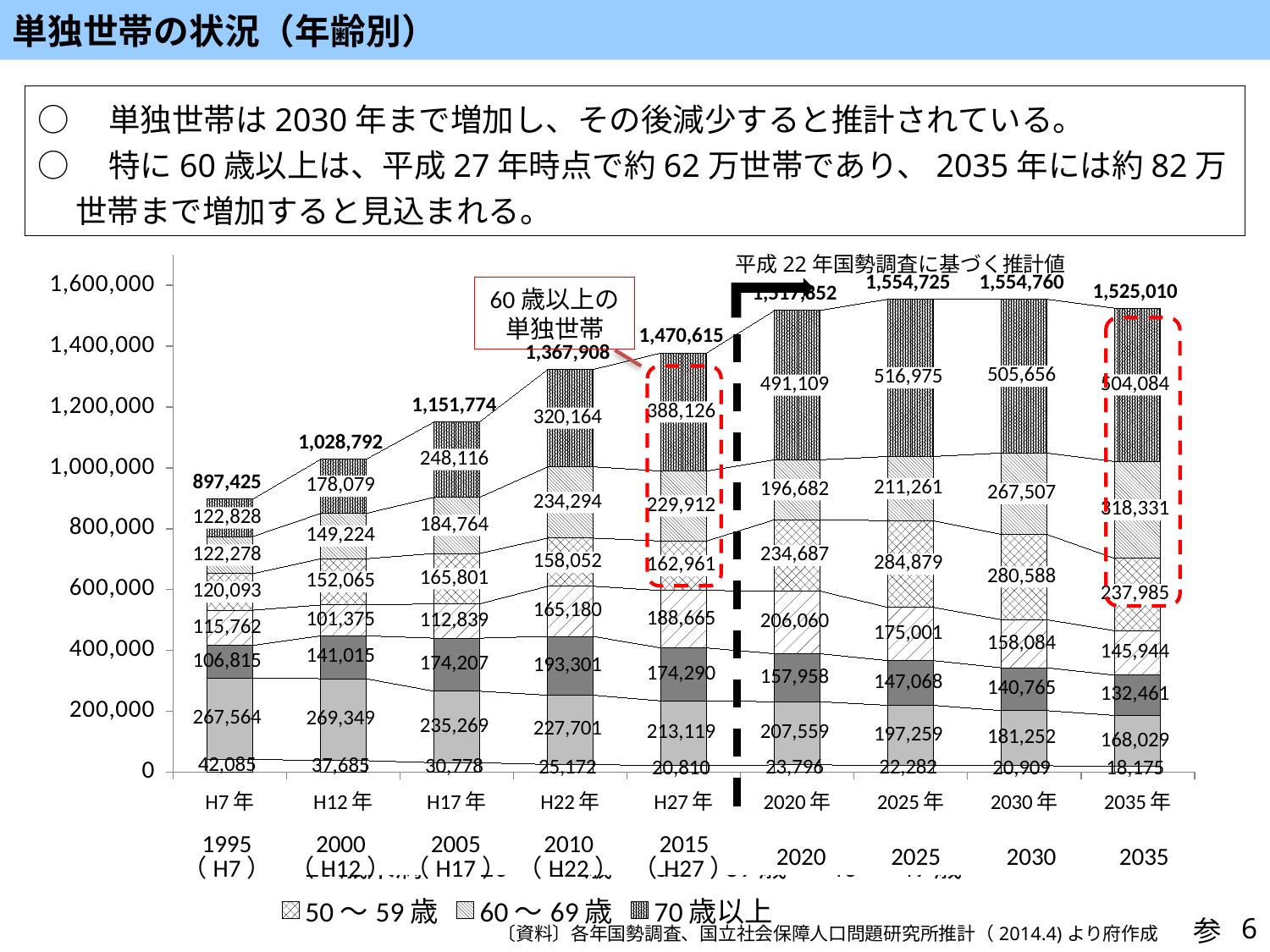
What kind of chart is shown on the slide? Stacked bar chart What is the value of the 70歳以上 segment for 2035年? 504,084 How much larger is the 70歳以上 value in 2035年 than in H27年? 115,958 What is the value of the 60～69歳 segment for 2025年? 211,261 How many years (bars) are plotted in the chart? 9 What does the label next to the red dashed box say the highlighted segments represent? 60歳以上の単独世帯 What is the total number of single-person households shown for H27年 (2015)? 1,470,615 Does the 70歳以上 segment rise or fall from H7年 to 2035年? Rise Which year has the lowest 70歳以上 value? H7年 (1995) What is the value of the 50～59歳 segment for H22年 (2010)? 158,052 Which is larger, the 70歳以上 value for 2020年 or for 2025年? 2025年 Which year has the lowest total of single-person households? H7年 (1995)